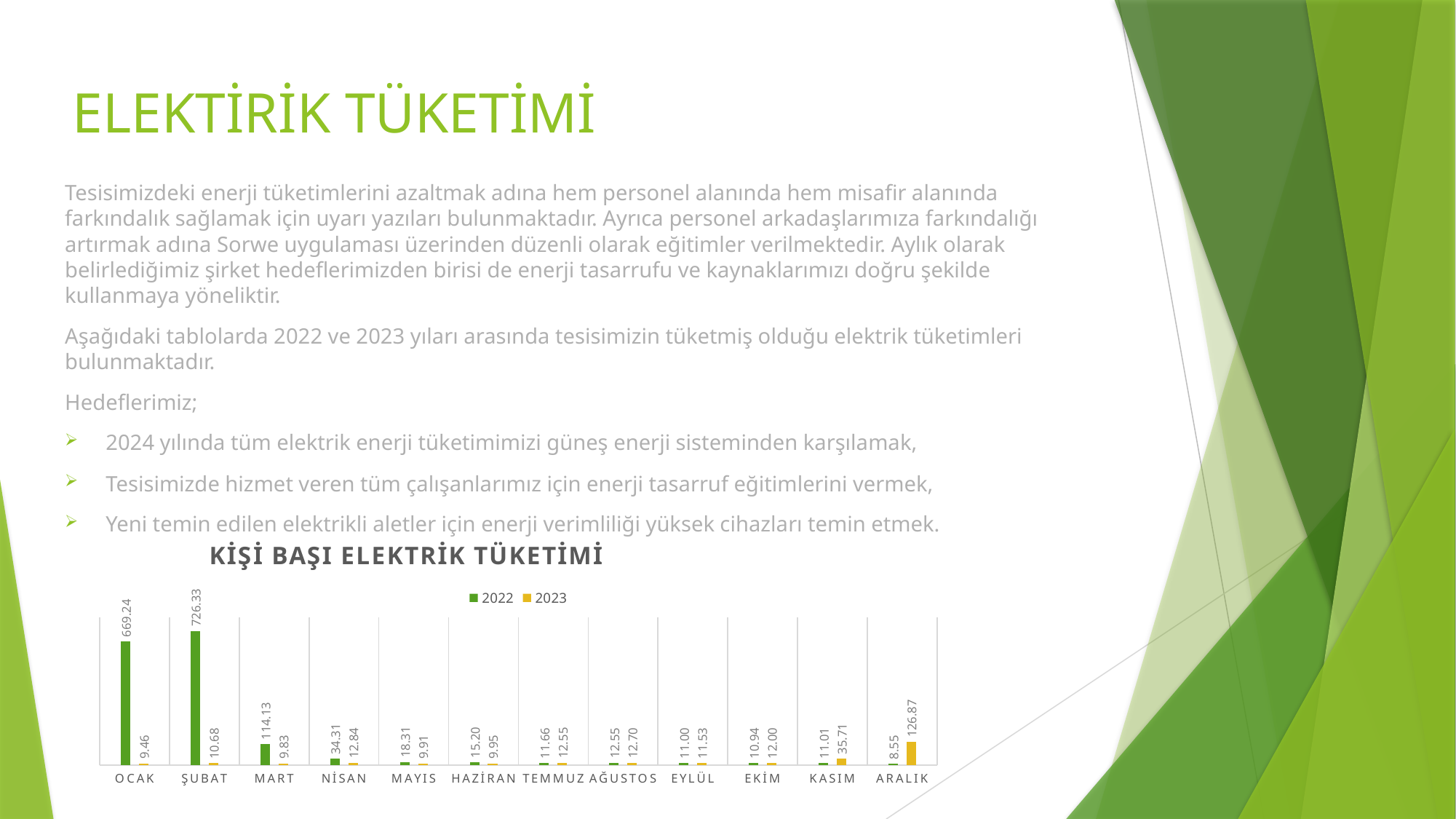
Which month has the highest 2022 value? ŞUBAT How many series does the legend list? 2 What is the difference between the 2022 and 2023 values for OCAK? 659.78 What is the 2022 value for ŞUBAT? 726.33 Which is larger for ARALIK, the 2022 value or the 2023 value? 2023 What is the 2023 value for KASIM? 35.71 What is the 2023 value for ARALIK? 126.87 Which month has the lowest 2022 value? ARALIK What kind of chart is shown on the slide? Bar chart What is the 2022 value for MART? 114.13 Which month has the highest 2023 value? ARALIK How many months are shown on the x axis? 12